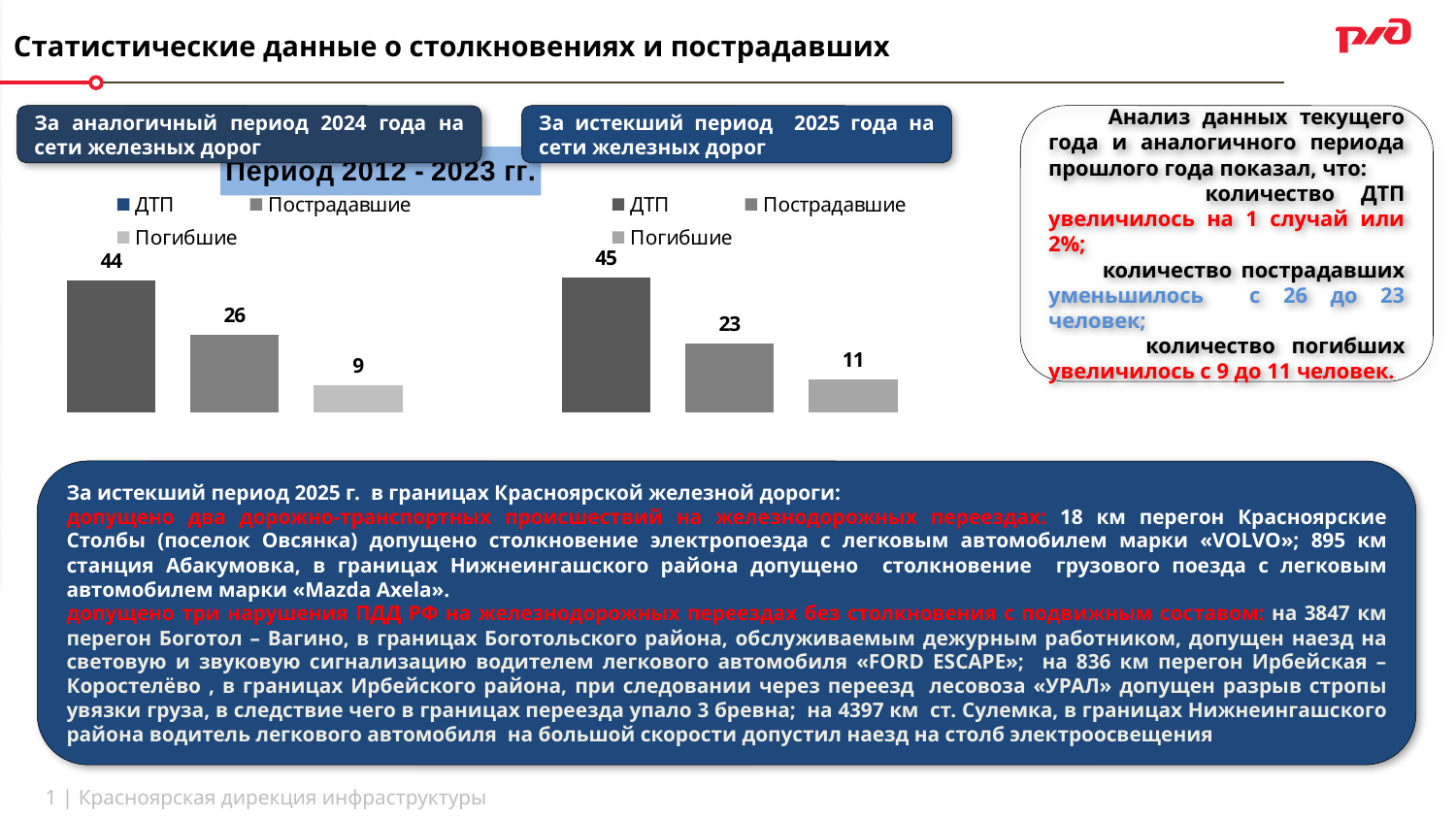
How many bars are plotted on the right chart (2025 period)? 3 On the left chart (2024 period), which category has the lowest value? Погибшие On the left chart (2024 period), what is the value for Пострадавшие? 26 On the left chart (2024 period), what is the difference between ДТП and Пострадавшие? 18 What type of chart is the left chart (2024 period)? Bar chart On the right chart (2025 period), what is the difference between Пострадавшие and Погибшие? 12 Which is larger: Пострадавшие on the left chart (2024) or Пострадавшие on the right chart (2025)? Left chart (2024), 26 On the right chart (2025 period), which category has the highest value? ДТП How many series does the legend of the right chart (2025 period) list? 3 On the right chart (2025 period), what is the value for Погибшие? 11 On the left chart (2024 period), what is the value for ДТП? 44 On the right chart (2025 period), what is the value for ДТП? 45